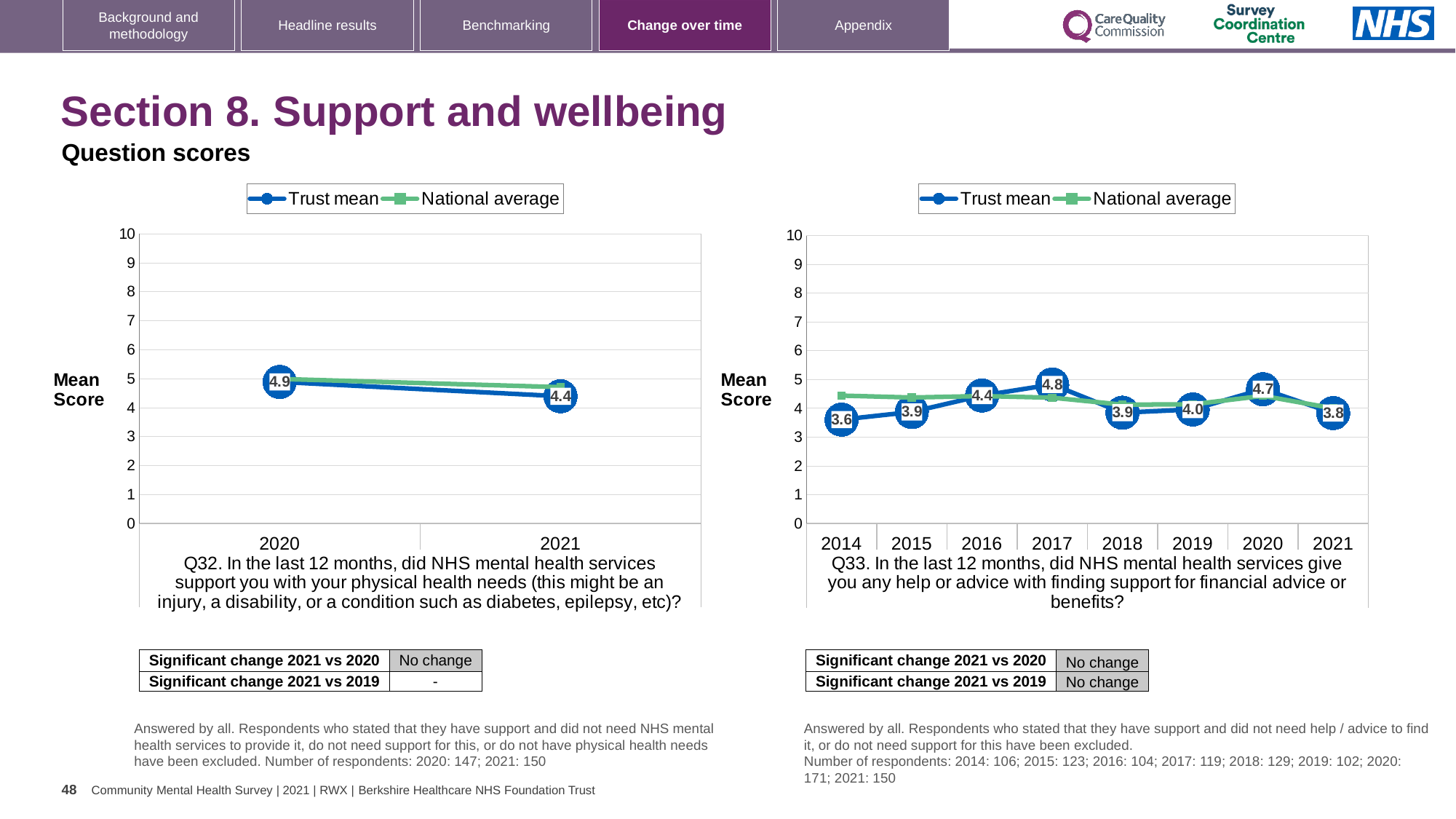
How many series does the legend of the Q32 chart on the left list? 2 In the Q33 chart on the right, what is the Trust mean score for 2017? 4.8 In the Q32 chart on the left, what is the Trust mean score for 2021? 4.4 In the Q32 chart on the left, what is the Trust mean score for 2020? 4.9 In the Q33 chart on the right, what is the Trust mean score for 2014? 3.6 In the Q32 chart on the left, by how much did the Trust mean fall from 2020 to 2021? 0.5 In the Q33 chart on the right, what is the difference between the Trust mean scores for 2020 and 2021? 0.9 In the Q33 chart on the right, is the Trust mean score for 2016 greater or less than 4? greater In the Q32 chart on the left, does the Trust mean rise or fall from 2020 to 2021? fall In the Q33 chart on the right, which year has the lowest Trust mean score? 2014 In the Q33 chart on the right, how many years are shown on the x axis? 8 In the Q33 chart on the right, which year has the highest Trust mean score? 2017